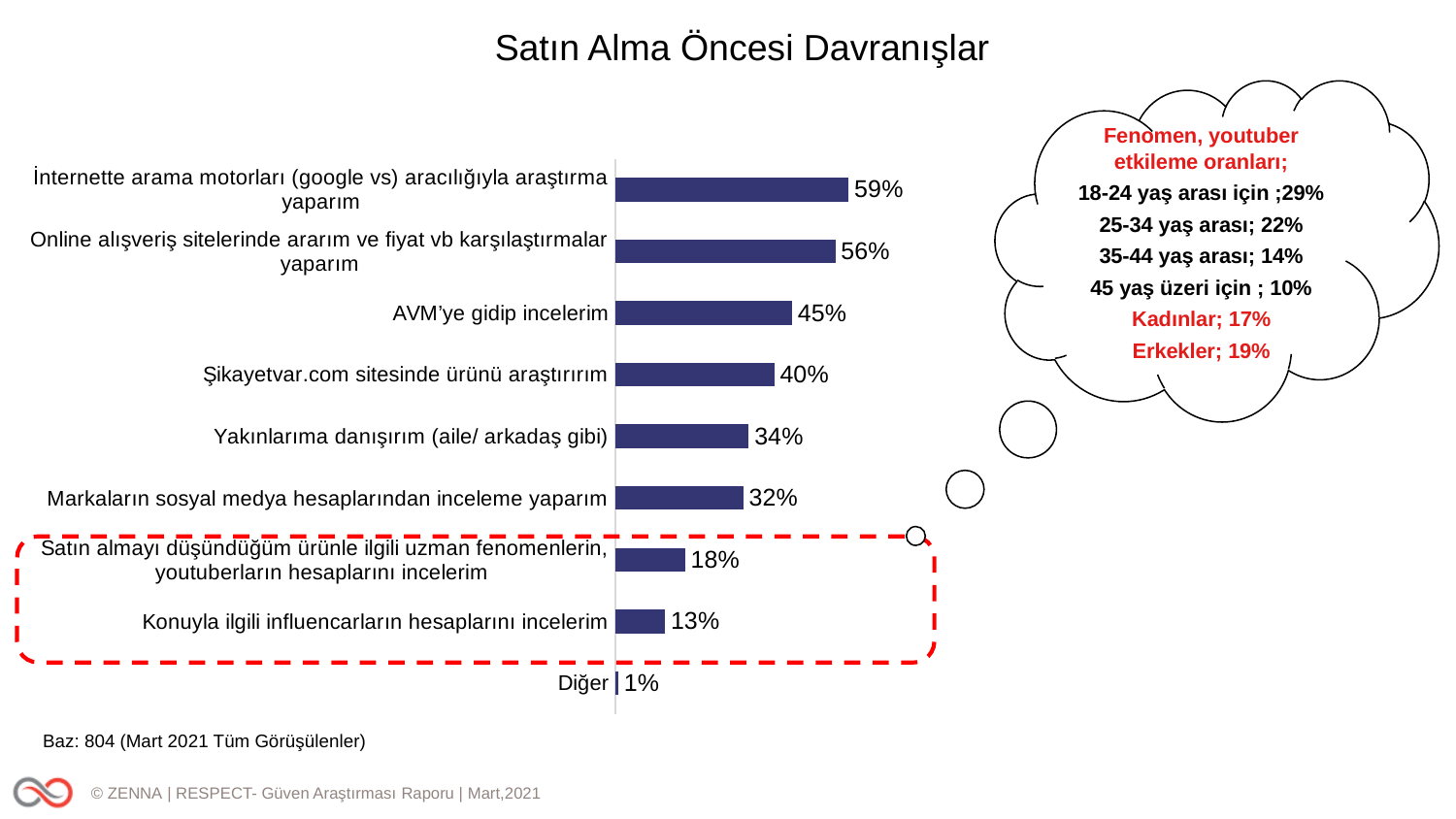
What is the difference between the highest value and "Online alışveriş sitelerinde ararım ve fiyat vb karşılaştırmalar yaparım"? 3% What is the difference between "Yakınlarıma danışırım (aile/ arkadaş gibi)" and "Markaların sosyal medya hesaplarından inceleme yaparım"? 2% Which category has the lowest value? Diğer How many categories does the chart show? 9 What is the value for "Konuyla ilgili influencarların hesaplarını incelerim"? 13% What kind of chart is shown on the slide? Bar chart What is the value for "Şikayetvar.com sitesinde ürünü araştırırım"? 40% What is the value for "AVM'ye gidip incelerim"? 45% Which is larger: "Satın almayı düşündüğüm ürünle ilgili uzman fenomenlerin, youtuberların hesaplarını incelerim" or "Konuyla ilgili influencarların hesaplarını incelerim"? Satın almayı düşündüğüm ürünle ilgili uzman fenomenlerin, youtuberların hesaplarını incelerim What is the base (Baz) stated below the chart? 804 (Mart 2021 Tüm Görüşülenler) What is the title of the slide? Satın Alma Öncesi Davranışlar Which category has the highest value? İnternette arama motorları (google vs) aracılığıyla araştırma yaparım